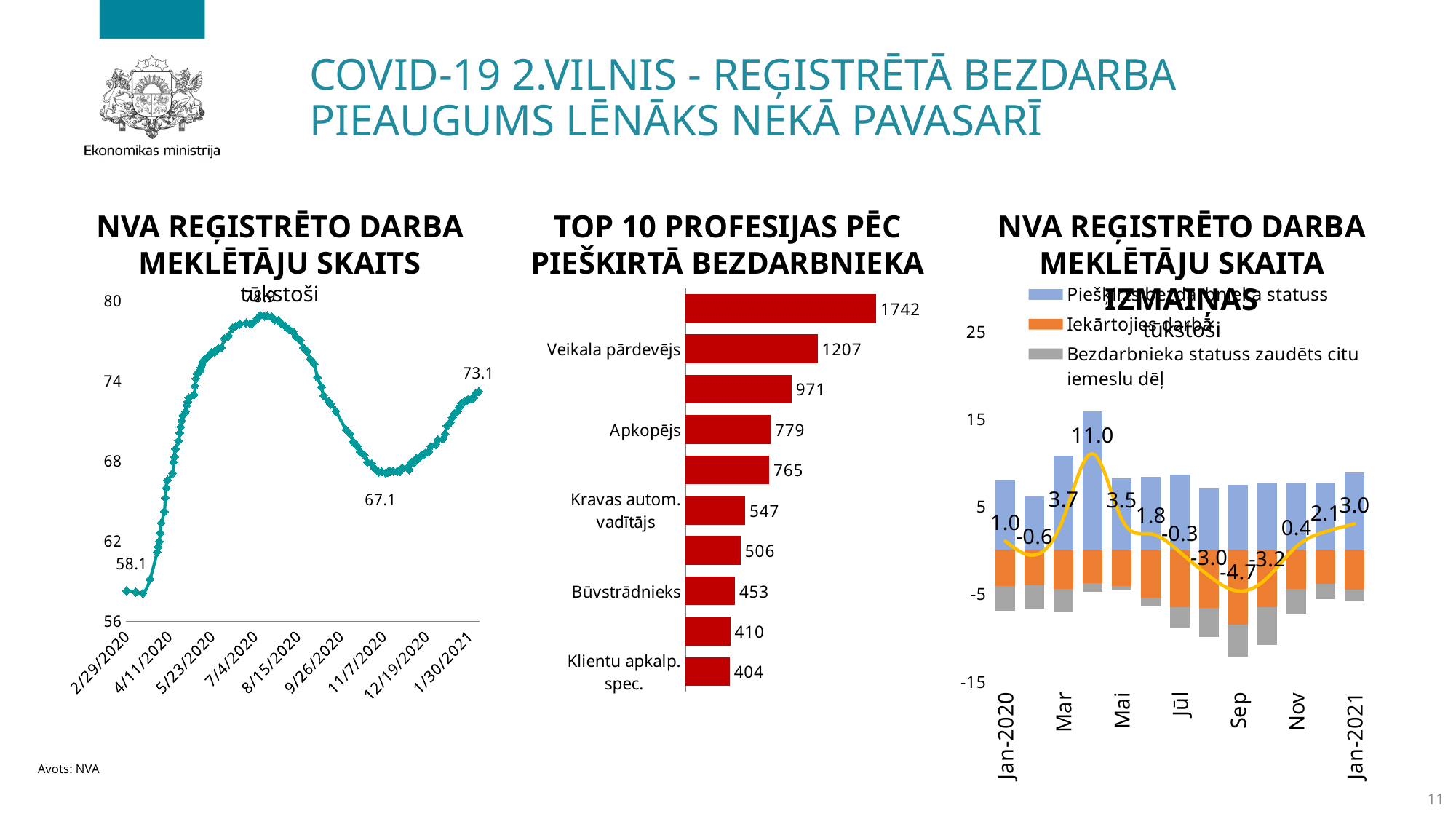
In the right chart 'NVA REĢISTRĒTO DARBA MEKLĒTĀJU SKAITA IZMAIŅAS', how many series does the legend list? 3 What kind of chart is the left chart titled 'NVA REĢISTRĒTO DARBA MEKLĒTĀJU SKAITS'? line chart In the right chart 'NVA REĢISTRĒTO DARBA MEKLĒTĀJU SKAITA IZMAIŅAS', what is the highest value labelled on the line? 11.0 In the middle chart 'TOP 10 PROFESIJAS PĒC PIEŠĶIRTĀ BEZDARBNIEKA', what is the value for Veikala pārdevējs? 1207 In the middle chart 'TOP 10 PROFESIJAS PĒC PIEŠĶIRTĀ BEZDARBNIEKA', how many bars are plotted? 10 In the right chart 'NVA REĢISTRĒTO DARBA MEKLĒTĀJU SKAITA IZMAIŅAS', what is the lowest value labelled on the line? -4.7 In the left chart 'NVA REĢISTRĒTO DARBA MEKLĒTĀJU SKAITS', what value is labelled at the trough around November 2020? 67.1 In the left chart 'NVA REĢISTRĒTO DARBA MEKLĒTĀJU SKAITS', what is the value labelled at the end of the line (1/30/2021)? 73.1 In the middle chart 'TOP 10 PROFESIJAS PĒC PIEŠĶIRTĀ BEZDARBNIEKA', which is larger: Būvstrādnieks or Klientu apkalp. spec.? Būvstrādnieks In the middle chart 'TOP 10 PROFESIJAS PĒC PIEŠĶIRTĀ BEZDARBNIEKA', what is the difference between Veikala pārdevējs and Apkopējs? 428 In the middle chart 'TOP 10 PROFESIJAS PĒC PIEŠĶIRTĀ BEZDARBNIEKA', what is the value of the longest bar? 1742 In the left chart 'NVA REĢISTRĒTO DARBA MEKLĒTĀJU SKAITS', what is the lowest labelled value on the line? 58.1